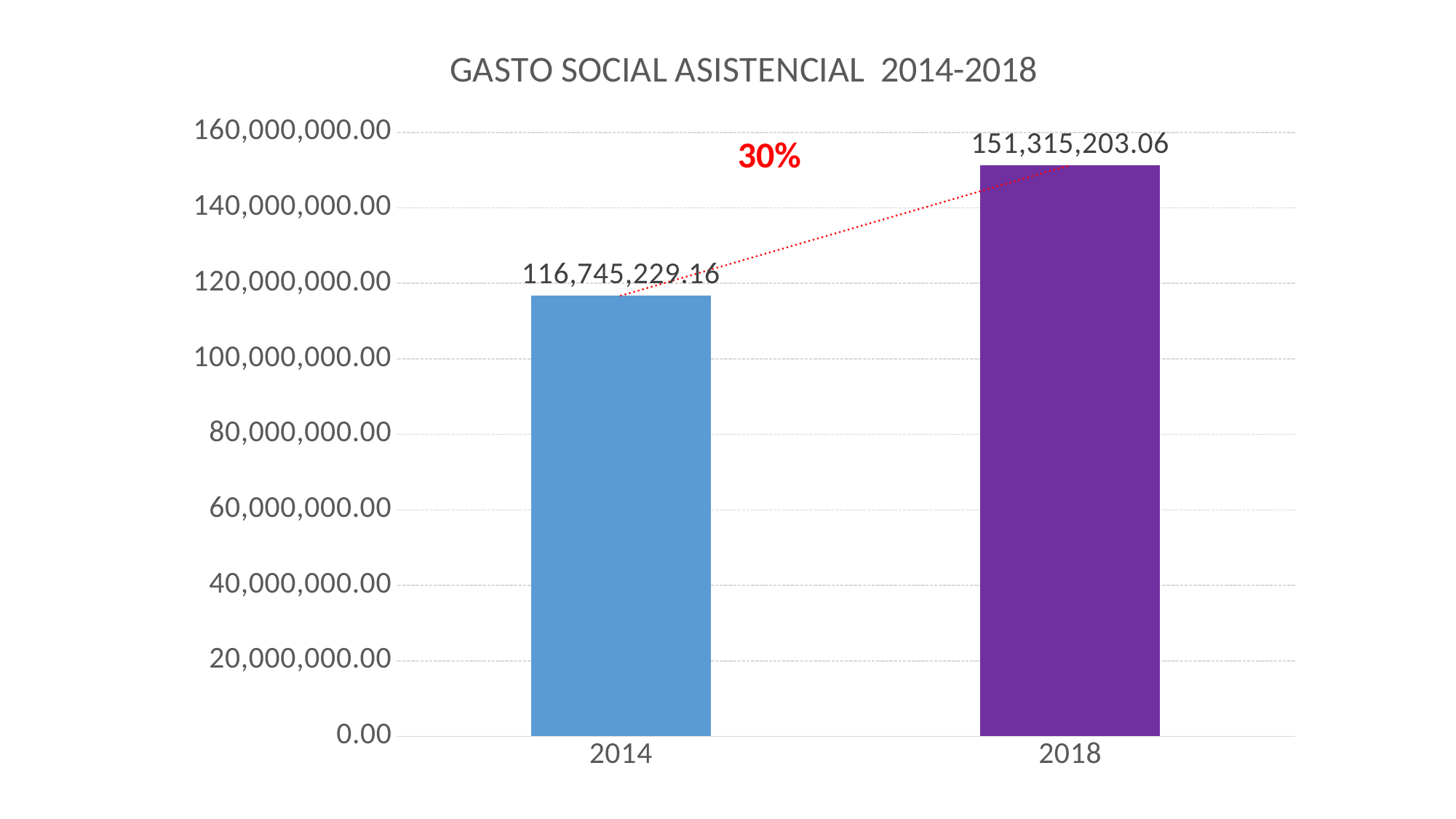
Is the value for 2018 greater or less than 140,000,000.00? greater How many bars are shown in the chart? 2 Is the value for 2014 greater or less than 120,000,000.00? less Which year has the lowest value? 2014 What is the title of the chart? GASTO SOCIAL ASISTENCIAL 2014-2018 Do the values rise or fall from 2014 to 2018? Rise What kind of chart is shown on the slide? Bar chart What is the value for 2014? 116,745,229.16 What is the value for 2018? 151,315,203.06 What is the difference between the 2018 value and the 2014 value? 34,569,973.90 Which year has the highest value? 2018 Which is larger, the value for 2014 or the value for 2018? 2018